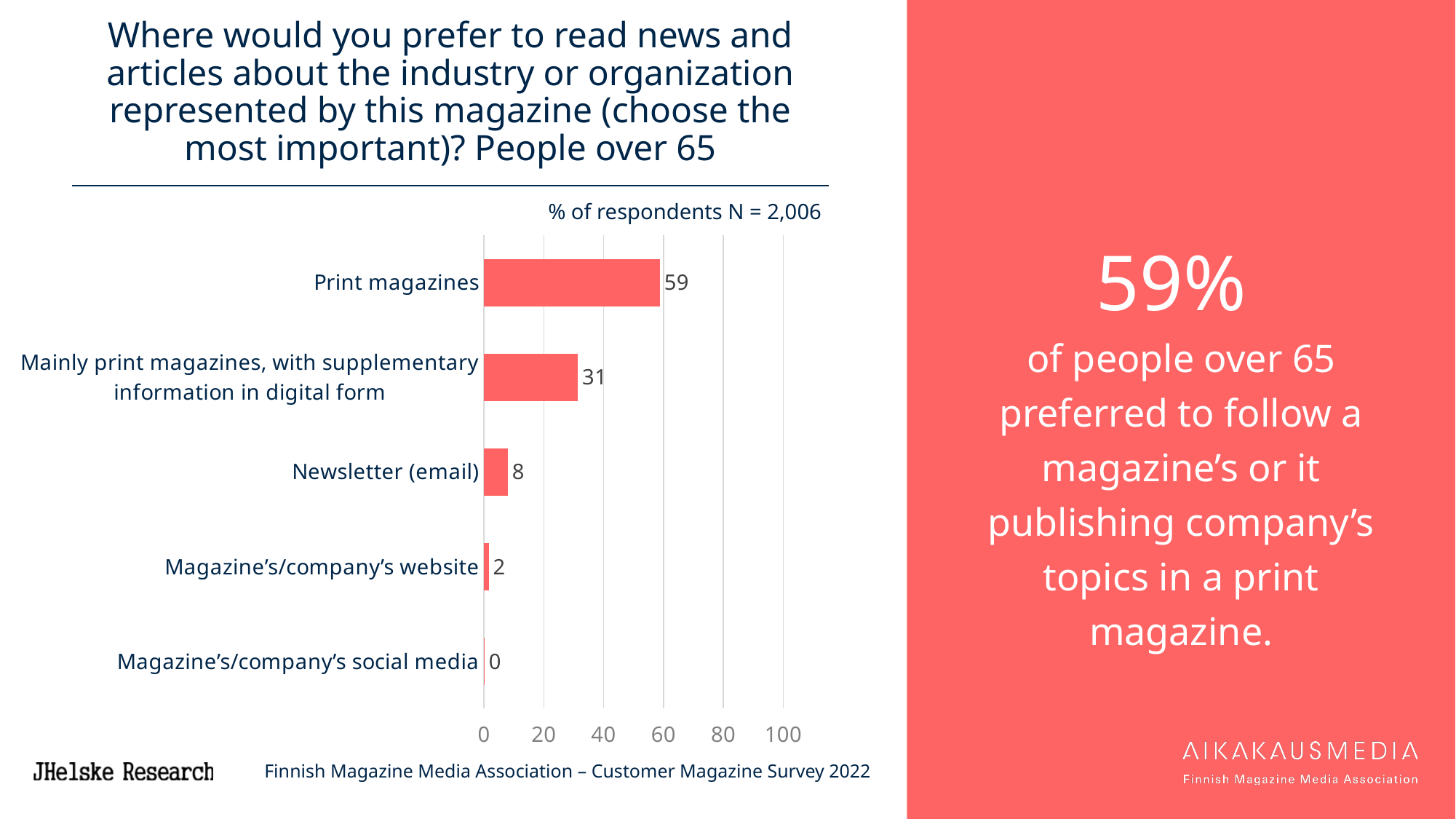
How many categories are shown in the chart? 5 What is the sample size (N) stated above the chart? 2,006 Which category has the lowest value? Magazine's/company's social media What kind of chart is shown on the slide? Bar chart What is the difference between the values for Print magazines and Mainly print magazines, with supplementary information in digital form? 28 What is the value for Newsletter (email)? 8 Is the value for Print magazines greater or less than 40? greater What is the value for Magazine's/company's website? 2 Which category has the highest value? Print magazines What is the value for Mainly print magazines, with supplementary information in digital form? 31 Which is larger, the value for Newsletter (email) or the value for Magazine's/company's website? Newsletter (email) What percentage of respondents chose Print magazines? 59